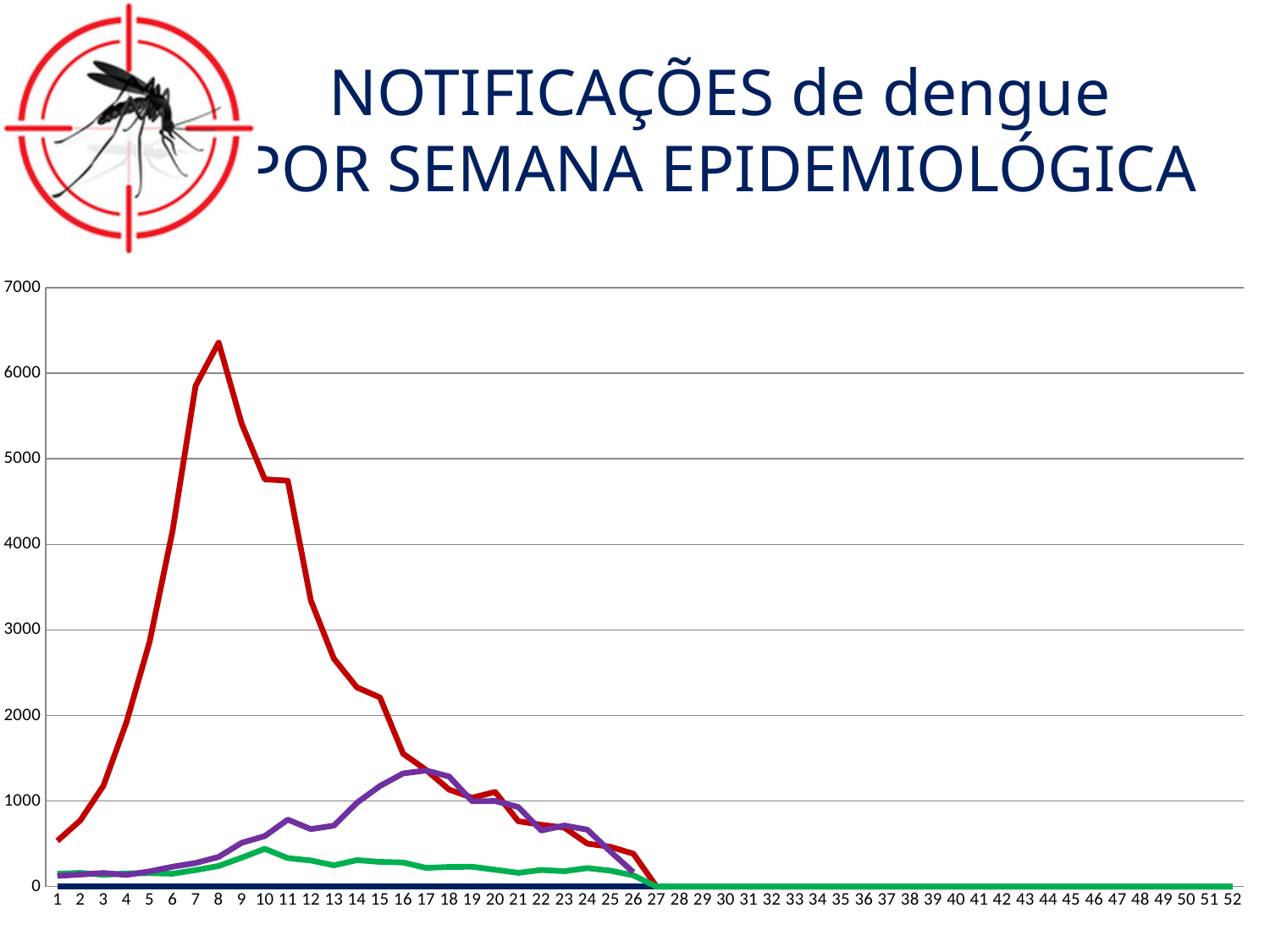
What kind of chart is shown on the slide? line chart Is the value of the red line at week 8 greater or less than 6000? greater Is the value of the red line at week 10 greater or less than 5000? less Is the value of the green line at week 10 greater or less than 1000? less How many epidemiological weeks are labelled along the x axis? 52 At which week does the red line reach its peak? 8 What is the highest value shown on the y axis? 7000 Does the red line rise or fall between week 8 and week 27? fall At week 10, which line has the larger value, the red line or the green line? red What is the title of the slide containing the chart? NOTIFICAÇÕES de dengue POR SEMANA EPIDEMIOLÓGICA Which coloured line reaches the highest value on the chart? red